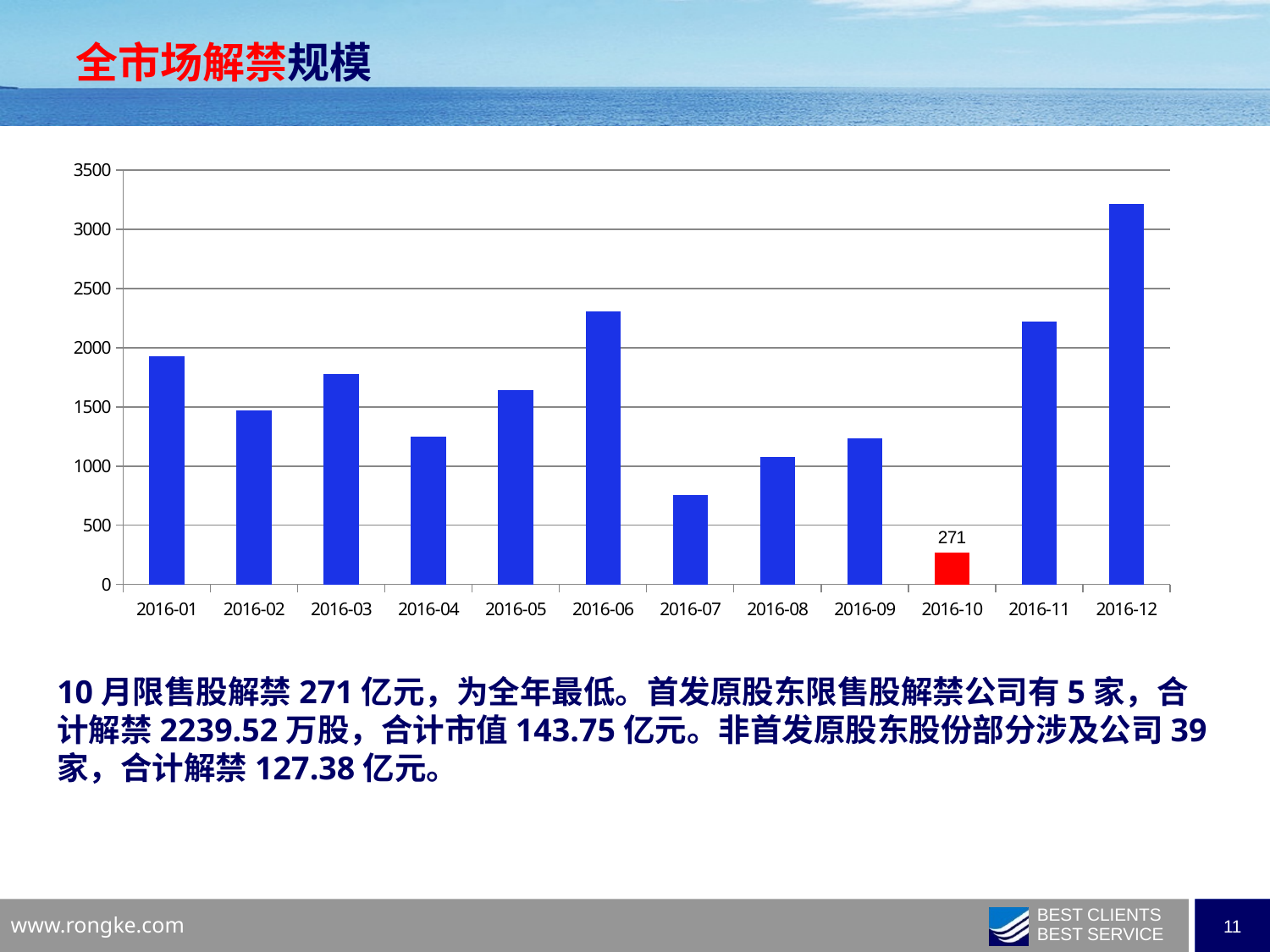
What kind of chart is shown on the slide? bar chart Which month has the highest bar? 2016-12 Which month has the lowest bar? 2016-10 Which month's bar is coloured red instead of blue? 2016-10 Which is larger, the value for 2016-01 or 2016-02? 2016-01 What is the value for 2016-10? 271 Is the value for 2016-07 greater or less than 1000? less Which is larger, the value for 2016-08 or 2016-09? 2016-09 How many months are shown on the x axis? 12 Is the value for 2016-06 greater or less than 2000? greater Is the value for 2016-12 greater or less than 3000? greater